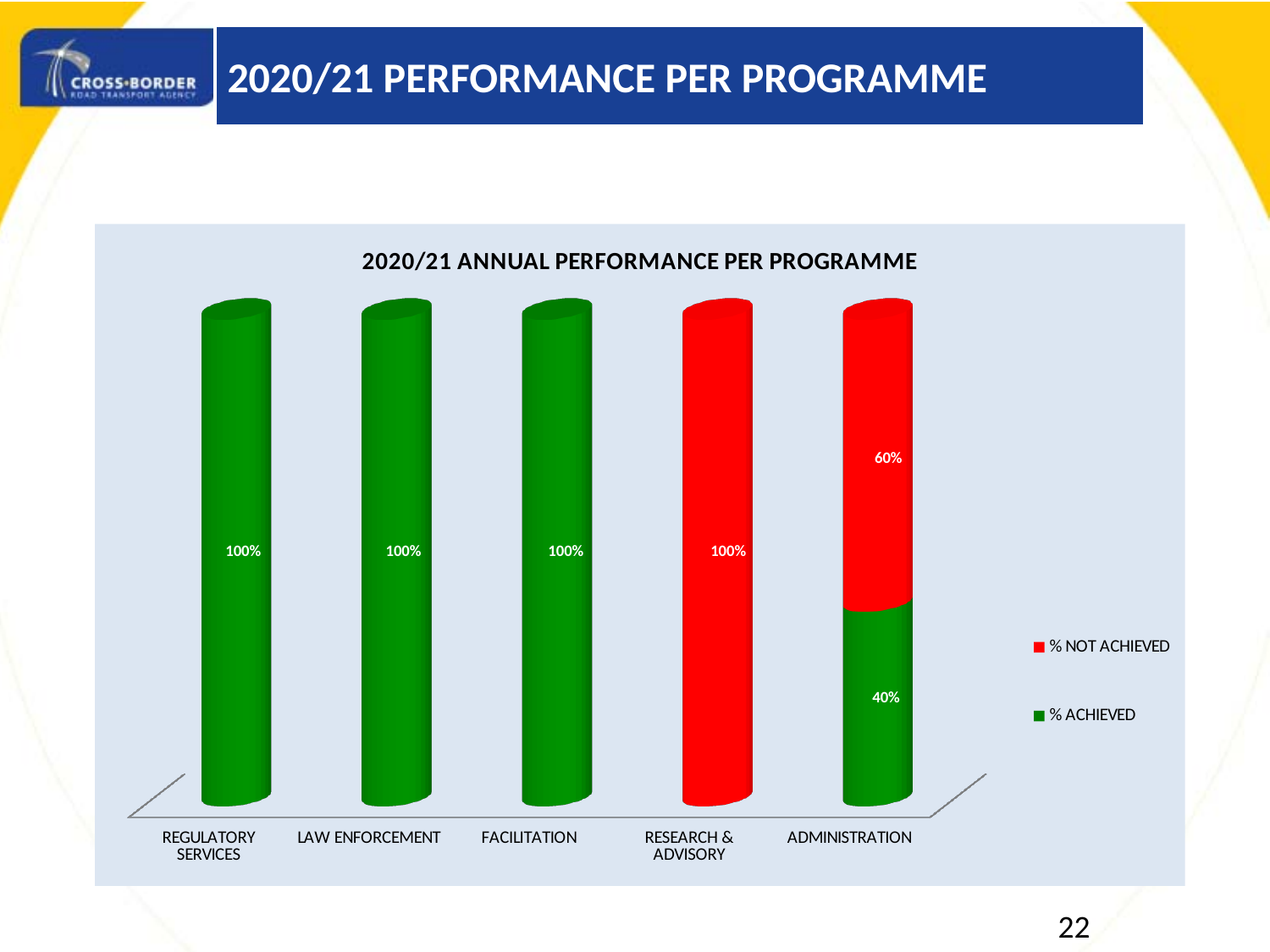
How many programmes are shown on the x axis of the chart? 5 What is the % ACHIEVED value for ADMINISTRATION? 40% What is the % NOT ACHIEVED value for RESEARCH & ADVISORY? 100% Which programme has the lowest % ACHIEVED value among those with a green segment? ADMINISTRATION What kind of chart is shown on the slide? Stacked bar chart How many series does the legend list? 2 What is the % ACHIEVED value for LAW ENFORCEMENT? 100% What is the difference between the % NOT ACHIEVED and % ACHIEVED values for ADMINISTRATION? 20% What is the % ACHIEVED value for REGULATORY SERVICES? 100% What is the % NOT ACHIEVED value for ADMINISTRATION? 60% For ADMINISTRATION, which is larger: % ACHIEVED or % NOT ACHIEVED? % NOT ACHIEVED Which colour represents % NOT ACHIEVED in the legend? Red